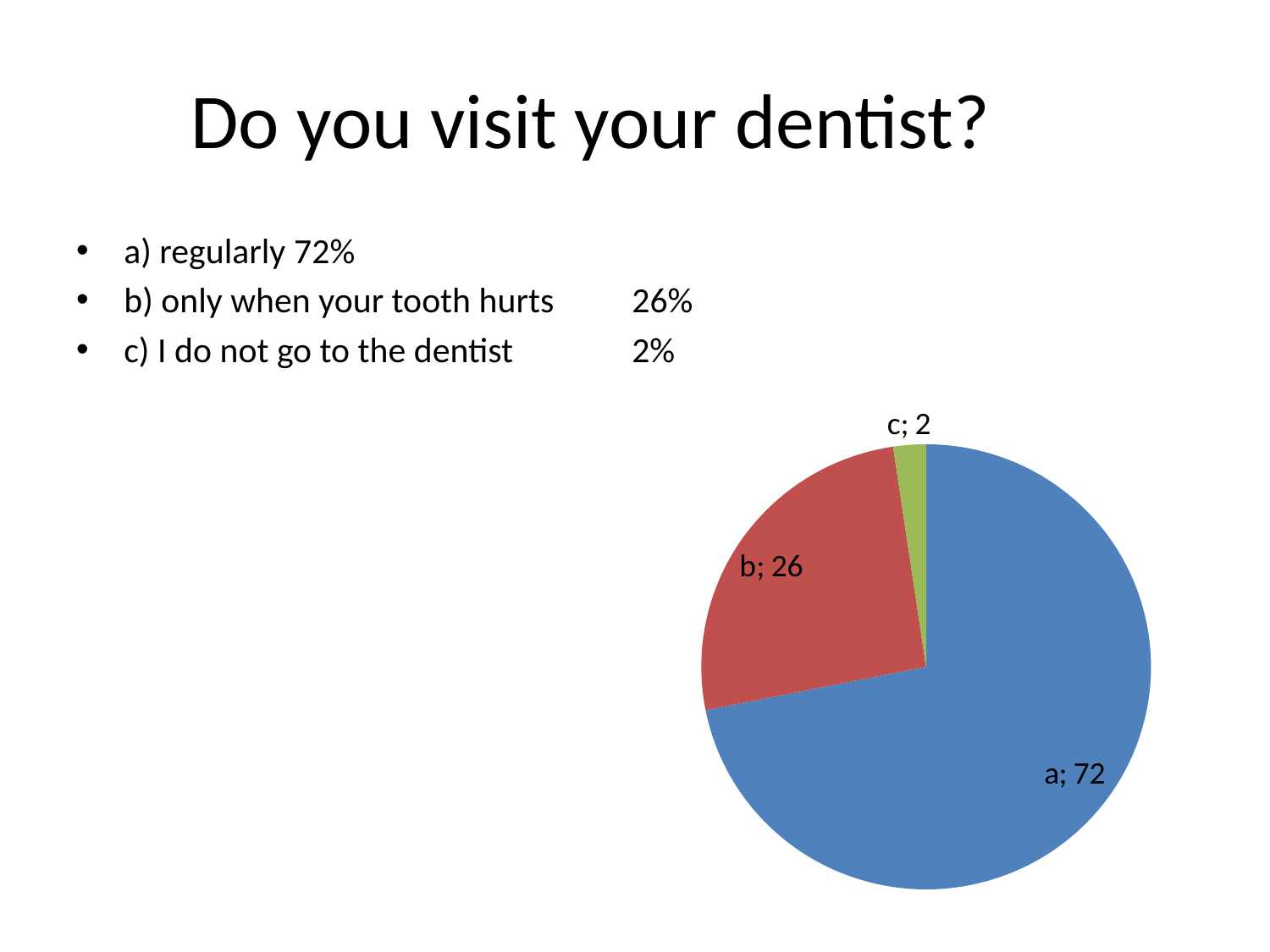
What kind of chart is shown on the slide? pie chart Which slice of the pie chart is the largest? a What is the value shown for slice c in the pie chart? 2 What is the value shown for slice a in the pie chart? 72 Which slice of the pie chart is the smallest? c What colour is slice b in the pie chart? red Which is larger, the value for slice b or the value for slice c? b What share of the pie does slice a represent? 72% How many slices does the pie chart have? 3 What is the difference between the values for slices b and c? 24 What is the value shown for slice b in the pie chart? 26 What is the difference between the values for slices a and b? 46